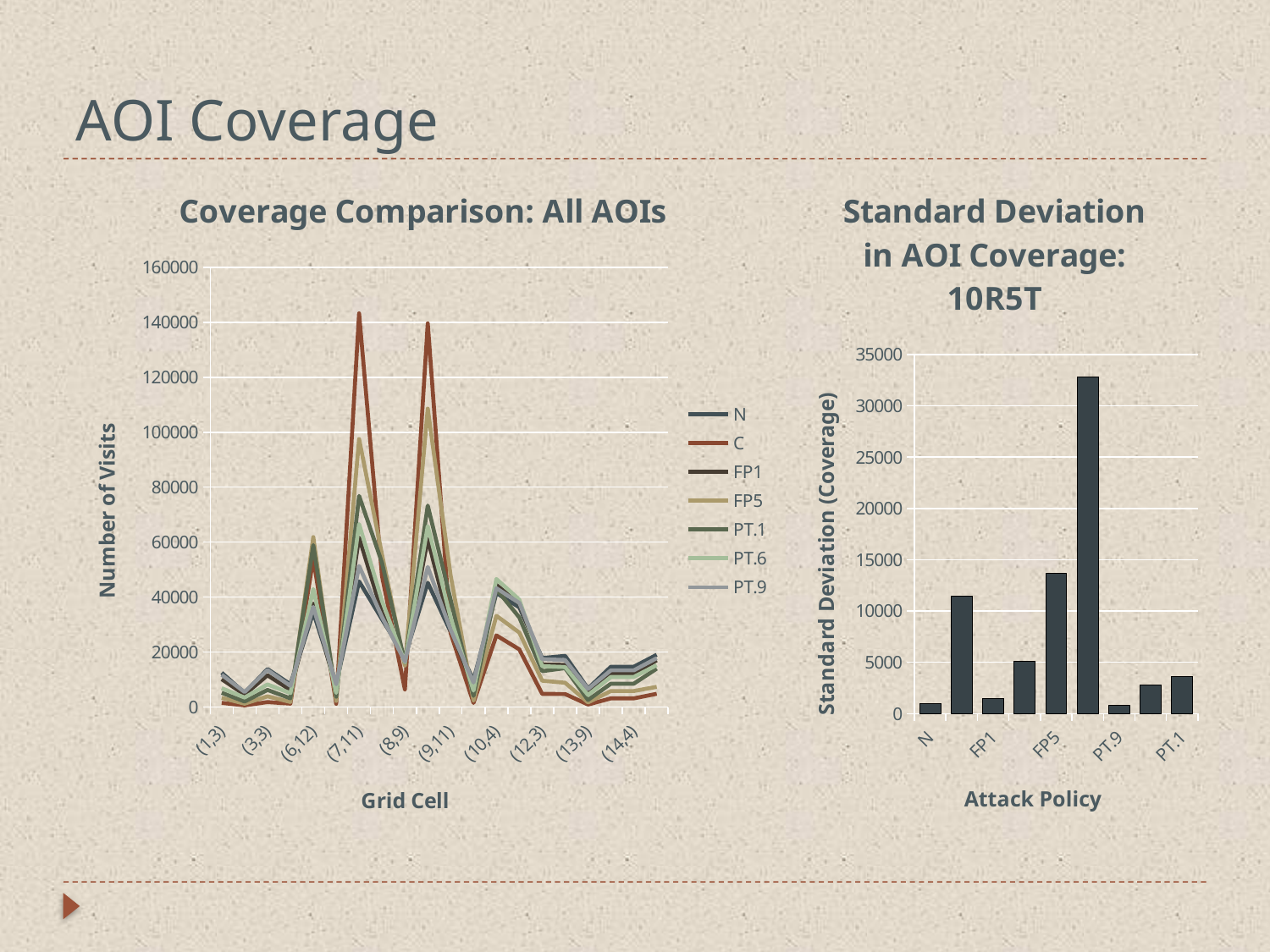
In the 'Coverage Comparison: All AOIs' chart, which series reaches the highest value at grid cell (7,11)? C In the 'Coverage Comparison: All AOIs' chart, is the value of series C at grid cell (7,11) greater or less than 120000? greater In the 'Standard Deviation in AOI Coverage: 10R5T' chart, is the value for FP5 greater or less than 10000? greater In the 'Standard Deviation in AOI Coverage: 10R5T' chart, is the value for N greater or less than 5000? less In the 'Standard Deviation in AOI Coverage: 10R5T' chart, which is larger, the value for FP5 or the value for FP1? FP5 What is the y-axis title of the 'Standard Deviation in AOI Coverage: 10R5T' chart? Standard Deviation (Coverage) In the 'Standard Deviation in AOI Coverage: 10R5T' chart, which is larger, the value for PT.1 or the value for PT.9? PT.1 What kind of chart is the 'Standard Deviation in AOI Coverage: 10R5T' chart? bar chart What kind of chart is the 'Coverage Comparison: All AOIs' chart? line chart In the 'Coverage Comparison: All AOIs' chart, how many series does the legend list? 7 What is the x-axis title of the 'Coverage Comparison: All AOIs' chart? Grid Cell